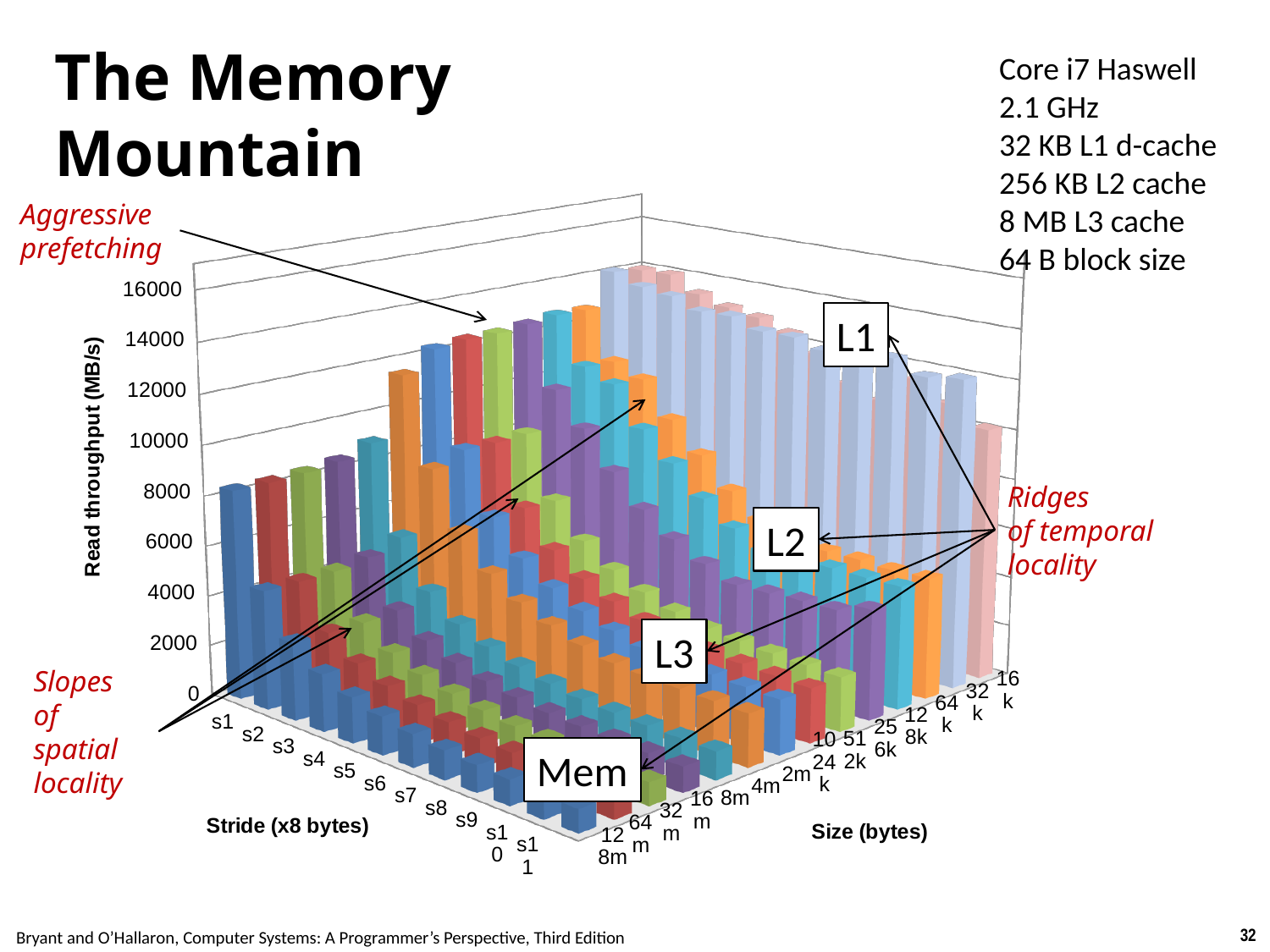
What is the highest tick value shown on the Read throughput axis? 16000 Which stride has the highest read throughput for the 128m size? s1 What is the largest size shown on the Size (bytes) axis? 128m What is the label of the axis showing s1 through s11? Stride (x8 bytes) Which cache level is labeled on the highest ridge of the memory mountain? L1 For stride s1, does read throughput rise or fall as the size decreases from 128m toward 16k? rise What is the smallest size shown on the Size (bytes) axis? 16k How many stride categories (s1, s2, ...) are shown on the stride axis? 11 How many size categories are shown on the Size (bytes) axis? 14 What kind of chart is shown on the slide? 3D bar chart For a fixed size, does read throughput rise or fall as the stride increases from s1 to s11? fall